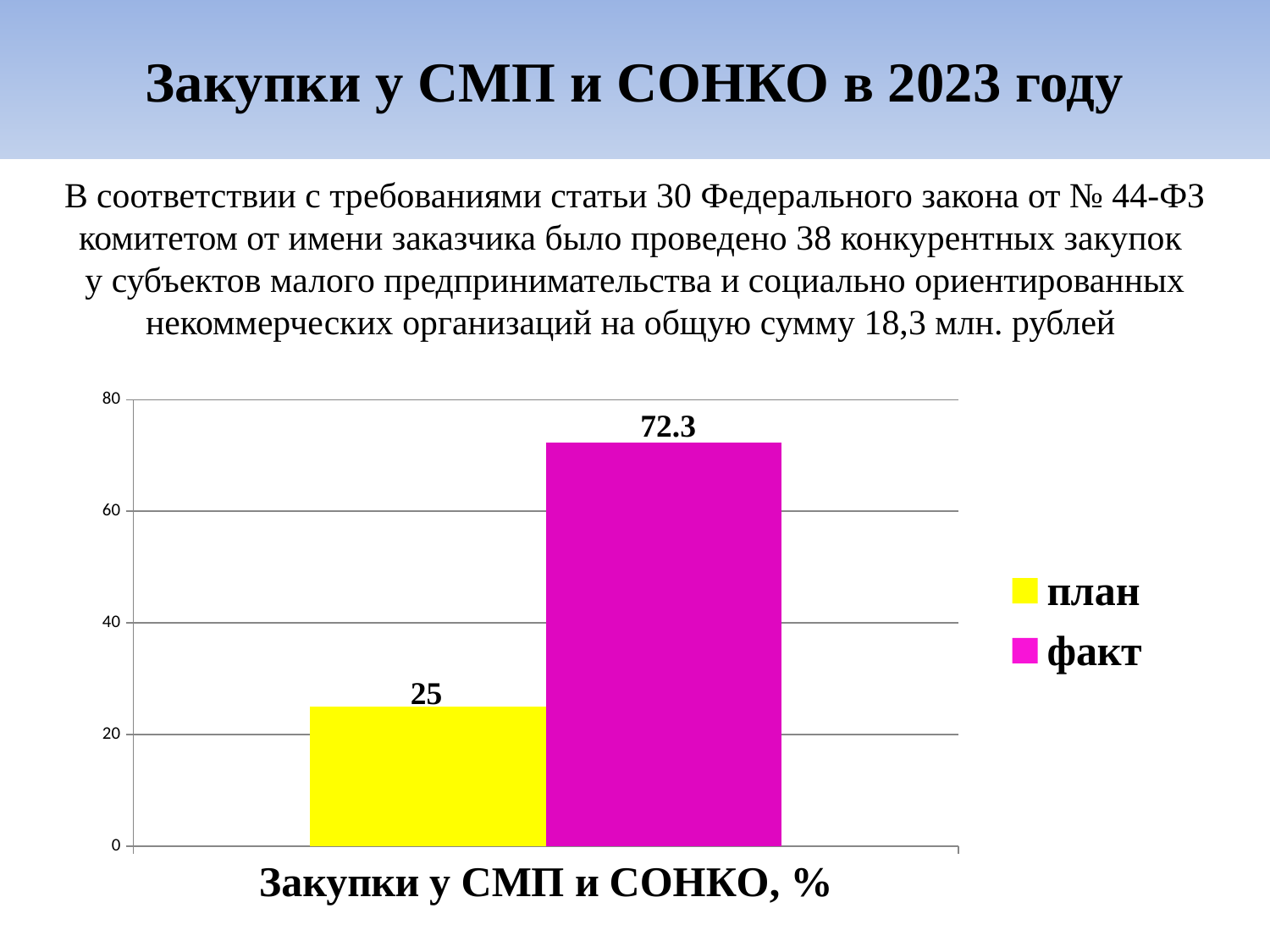
What colour is the "факт" bar? magenta What is the value of the "план" bar? 25 What kind of chart is shown on the slide? bar chart What is the label on the x axis of the chart? Закупки у СМП и СОНКО, % Which series has the higher value, "план" or "факт"? факт What is the highest value shown on the y axis? 80 What is the difference between the "факт" and "план" values? 47.3 How many series does the legend list? 2 What is the value of the "факт" bar? 72.3 Is the value for "план" greater or less than 40? less Which series has the lowest value? план Is the value for "факт" greater or less than 60? greater